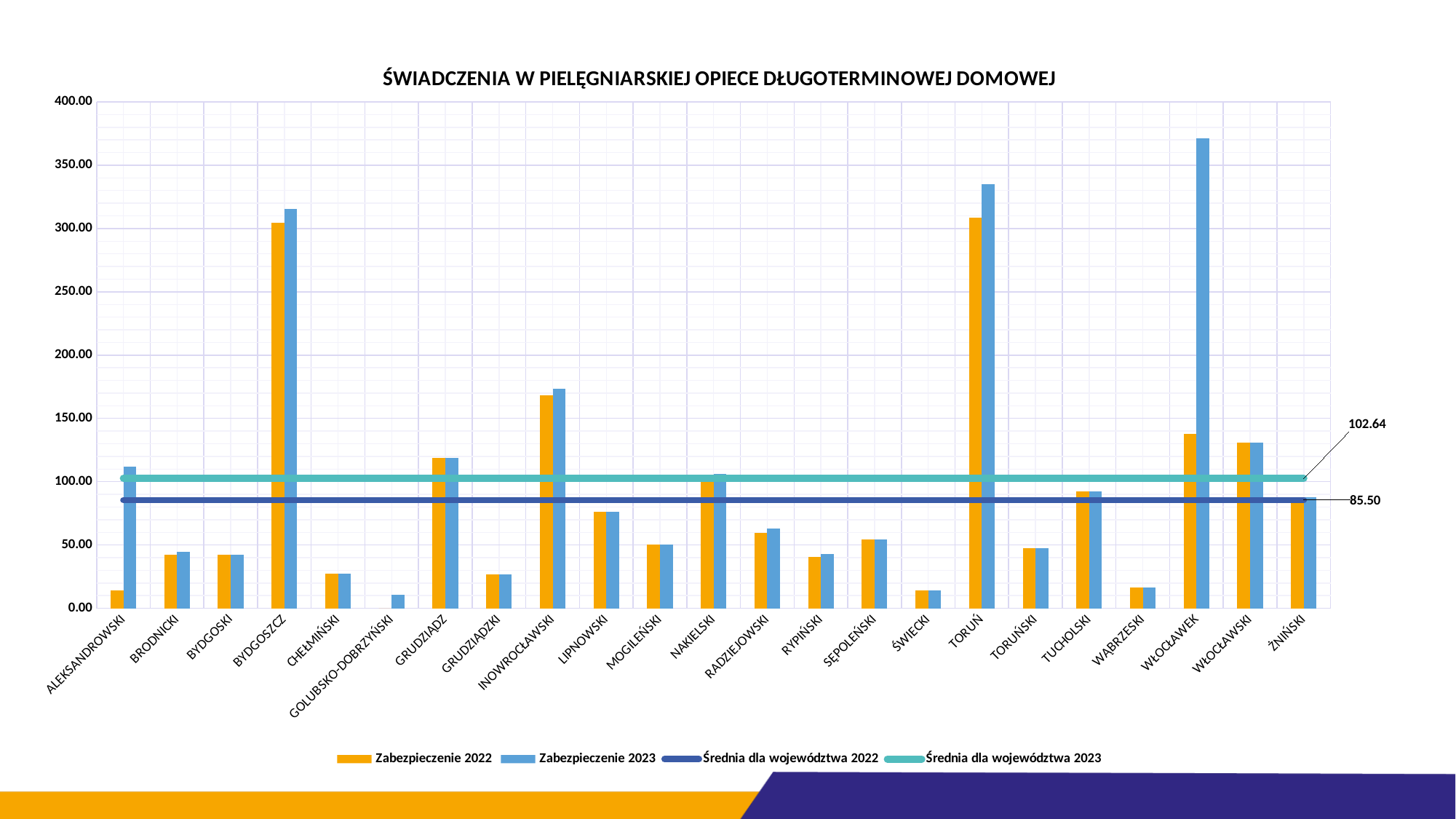
Which is larger: the Zabezpieczenie 2023 value for WŁOCŁAWEK or for TORUŃ? WŁOCŁAWEK What is the value of the Średnia dla województwa 2022 line? 85.50 Is the Zabezpieczenie 2022 value for INOWROCŁAWSKI greater or less than 150? greater Which category has the highest Zabezpieczenie 2023 value? WŁOCŁAWEK What is the title of the chart? ŚWIADCZENIA W PIELĘGNIARSKIEJ OPIECE DŁUGOTERMINOWEJ DOMOWEJ Is the Zabezpieczenie 2023 value for TORUŃ greater or less than 300? greater How many series does the legend list? 4 What is the value of the Średnia dla województwa 2023 line? 102.64 What is the difference between the Średnia dla województwa 2023 and Średnia dla województwa 2022 values? 17.14 Is the Zabezpieczenie 2022 value for WŁOCŁAWEK greater or less than 150? less Which category has the lowest Zabezpieczenie 2023 value? GOLUBSKO-DOBRZYŃSKI How many categories are shown on the x axis? 23